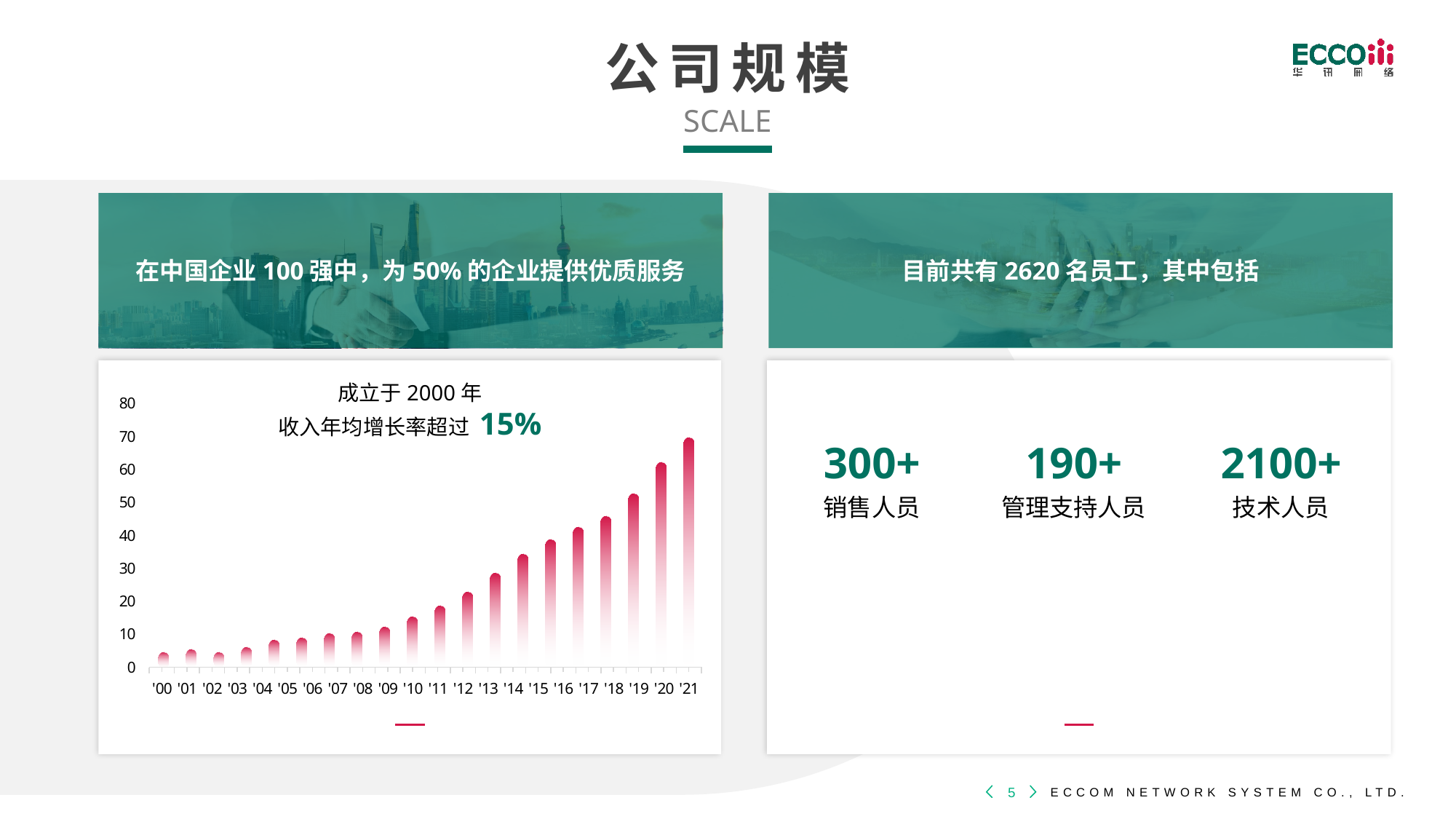
Is the value for '19 greater or less than 50? greater How many years are plotted along the x axis of the bar chart? 22 What kind of chart is shown on the left panel of the slide? bar chart Which is larger, the value for '21 or the value for '15? '21 Is the value for '21 greater or less than 60? greater Is the value for '15 greater or less than 40? less Do the values in the bar chart generally rise or fall from '00 to '21? rise What is the highest tick value shown on the y axis of the bar chart? 80 Which is larger, the value for '10 or the value for '19? '19 Which year has the highest bar in the chart? '21